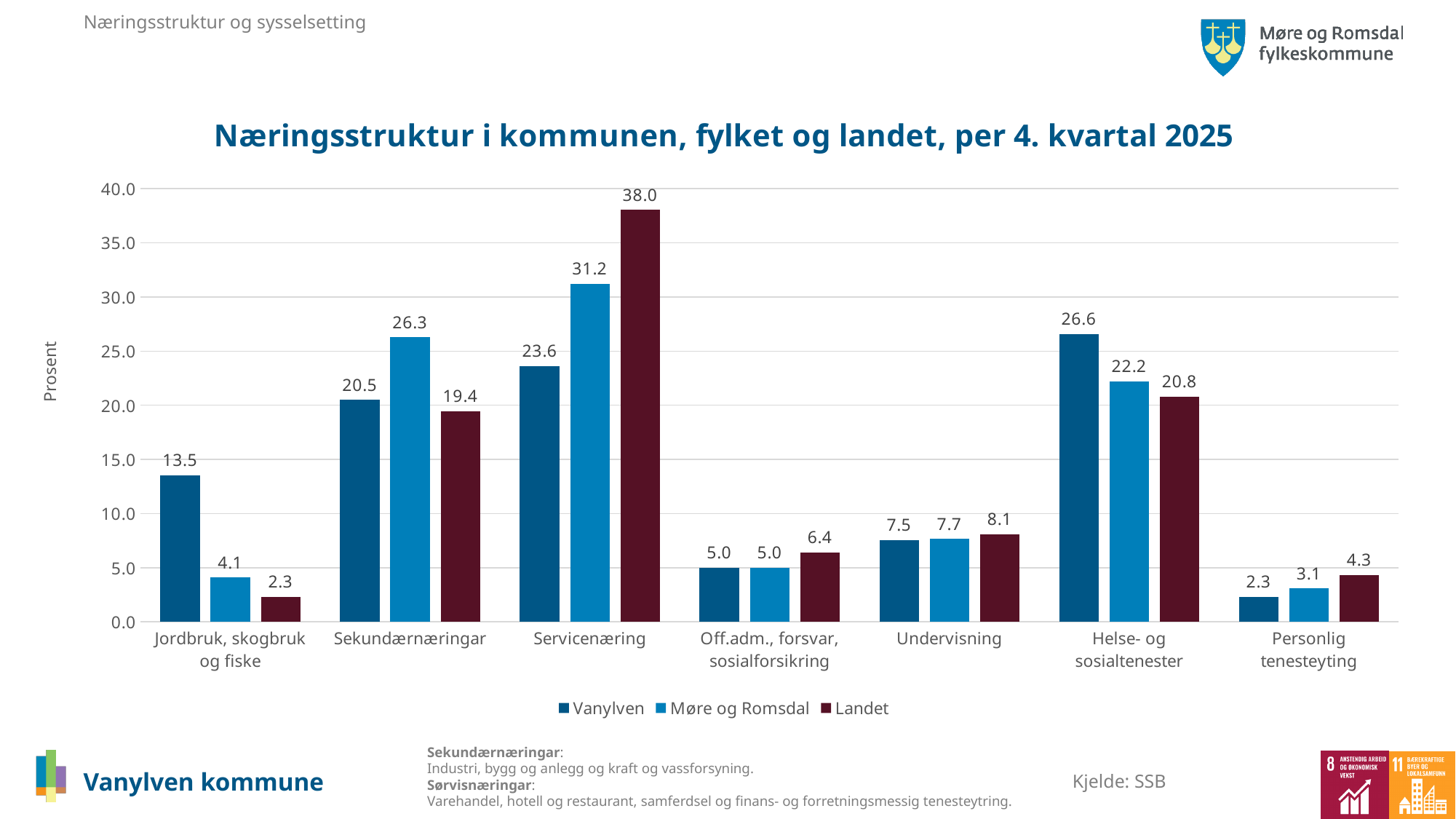
In the Sekundærnæringar category, which is larger: the value for Vanylven or the value for Landet? Vanylven How many series does the legend list? 3 What kind of chart is shown on the slide? Bar chart What is the label of the y axis? Prosent Which category has the lowest value for Landet? Jordbruk, skogbruk og fiske Is the value for Møre og Romsdal in the Servicenæring category greater or less than 30.0? greater Which category has the highest value for Vanylven? Helse- og sosialtenester How many categories are shown on the x axis? 7 What is the difference between the Landet and Vanylven values in the Servicenæring category? 14.4 What is the value for Møre og Romsdal in the Helse- og sosialtenester category? 22.2 What is the value for Vanylven in the Jordbruk, skogbruk og fiske category? 13.5 What is the value for Landet in the Servicenæring category? 38.0